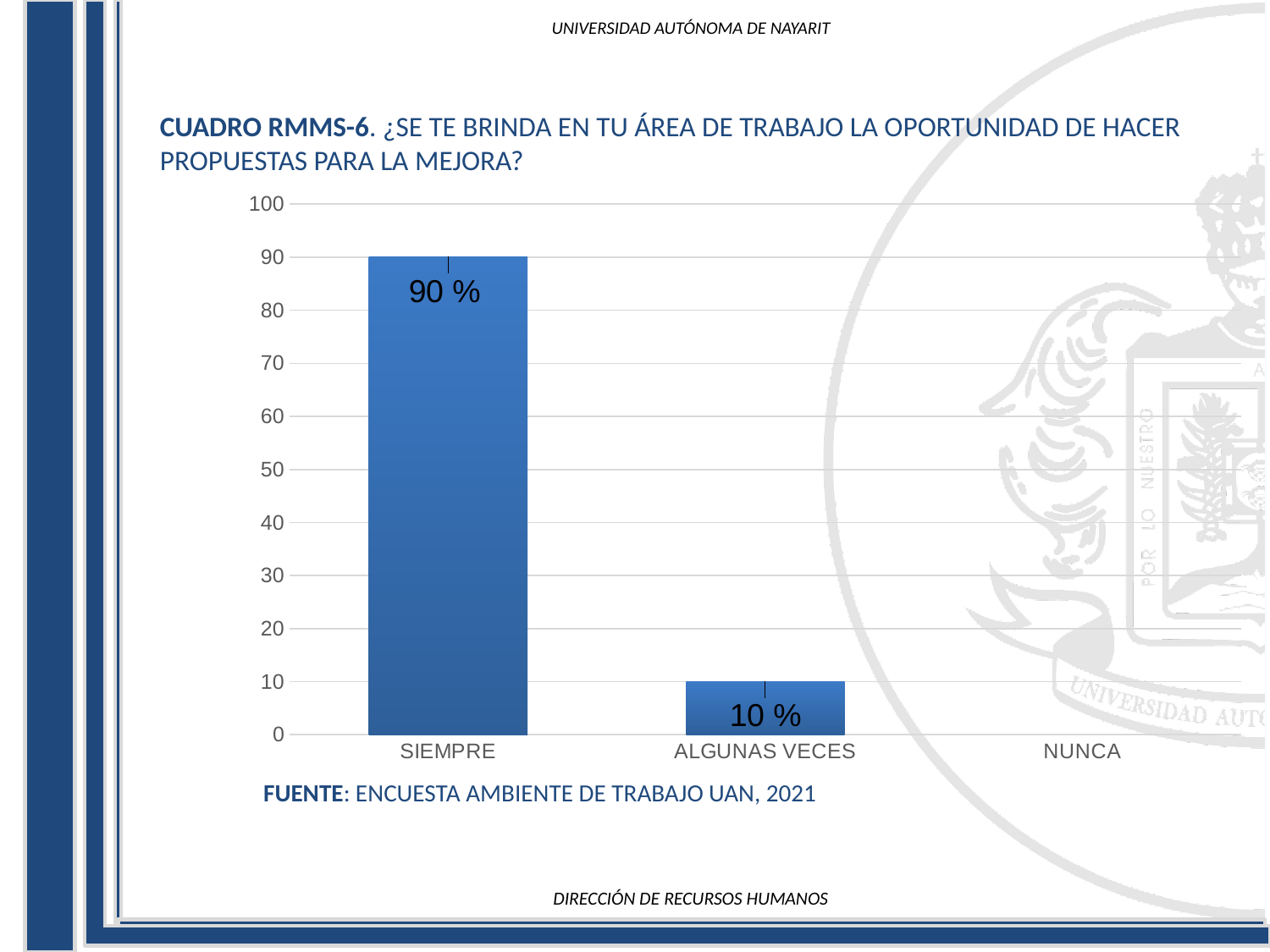
What is the value for ALGUNAS VECES? 10 % Is the value for ALGUNAS VECES greater or less than 20? less What is the value for SIEMPRE? 90 % What is the label of the third category on the x axis? NUNCA Do the values rise or fall from left to right along the x axis? fall What source is cited below the chart? ENCUESTA AMBIENTE DE TRABAJO UAN, 2021 Is the value for SIEMPRE greater or less than 50? greater Which category has the highest value? SIEMPRE What is the difference between the values for SIEMPRE and ALGUNAS VECES? 80 % How many categories are shown on the x axis? 3 What kind of chart is shown on the slide? bar chart Which is larger, the value for SIEMPRE or the value for ALGUNAS VECES? SIEMPRE